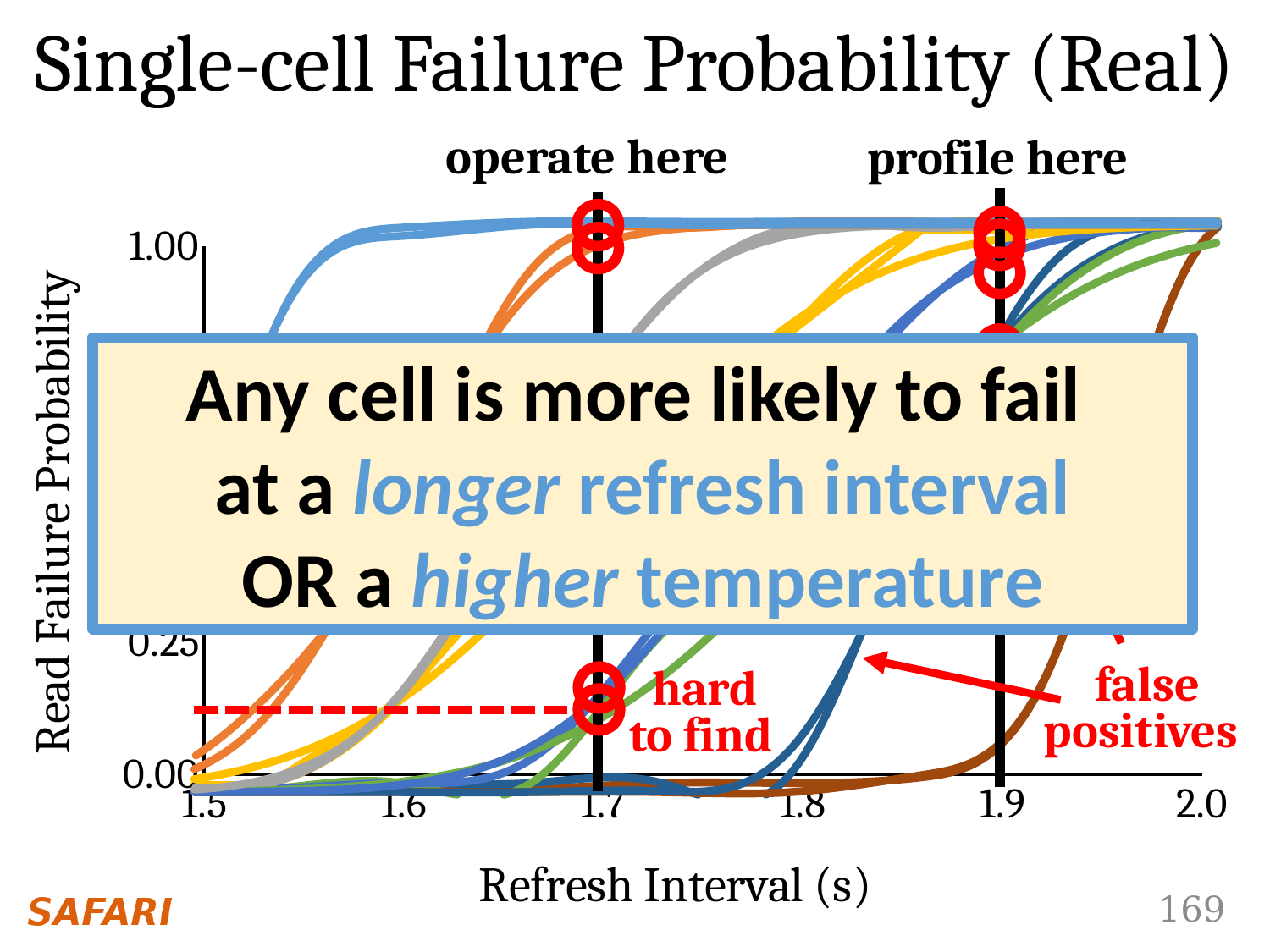
How many tick labels are shown on the x axis? 6 What kind of chart is shown on the slide? line chart Do the curves rise or fall as the refresh interval increases along the x axis? rise What is the largest refresh interval shown on the x axis? 2.0 At which refresh interval is the vertical line labelled "profile here" drawn? 1.9 What is the label of the x axis? Refresh Interval (s) Is the value of the brown curve at a refresh interval of 1.8 greater or less than 0.25? less What is the title of the chart on the slide? Single-cell Failure Probability (Real) What is the highest tick value shown on the y axis? 1.00 At which refresh interval is the vertical line labelled "operate here" drawn? 1.7 What is the label of the y axis? Read Failure Probability Is the value of the light blue curve at a refresh interval of 1.7 greater or less than 0.25? greater